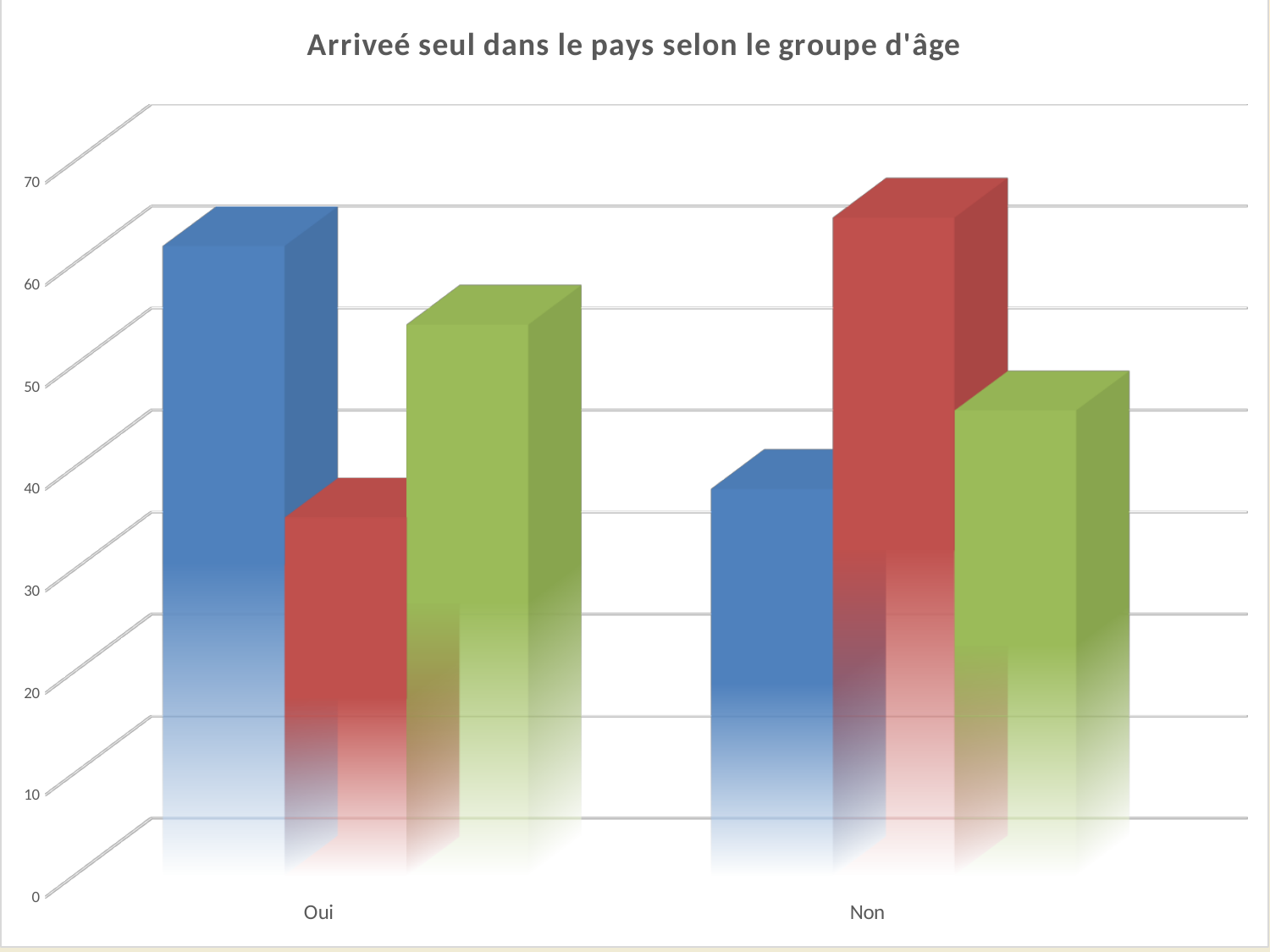
How many bars are plotted in total on the chart? 6 Is the value of the red bar for Oui greater or less than 40? less Which coloured bar is the tallest in the Oui category? blue In the Non category, which is larger, the blue bar or the red bar? red How many categories are shown on the x axis? 2 Is the value of the green bar for Non greater or less than 50? less Is the value of the blue bar for Oui greater or less than 50? greater What is the title of the chart? Arriveé seul dans le pays selon le groupe d'âge What kind of chart is shown on the slide? bar chart Which coloured bar is the tallest in the Non category? red